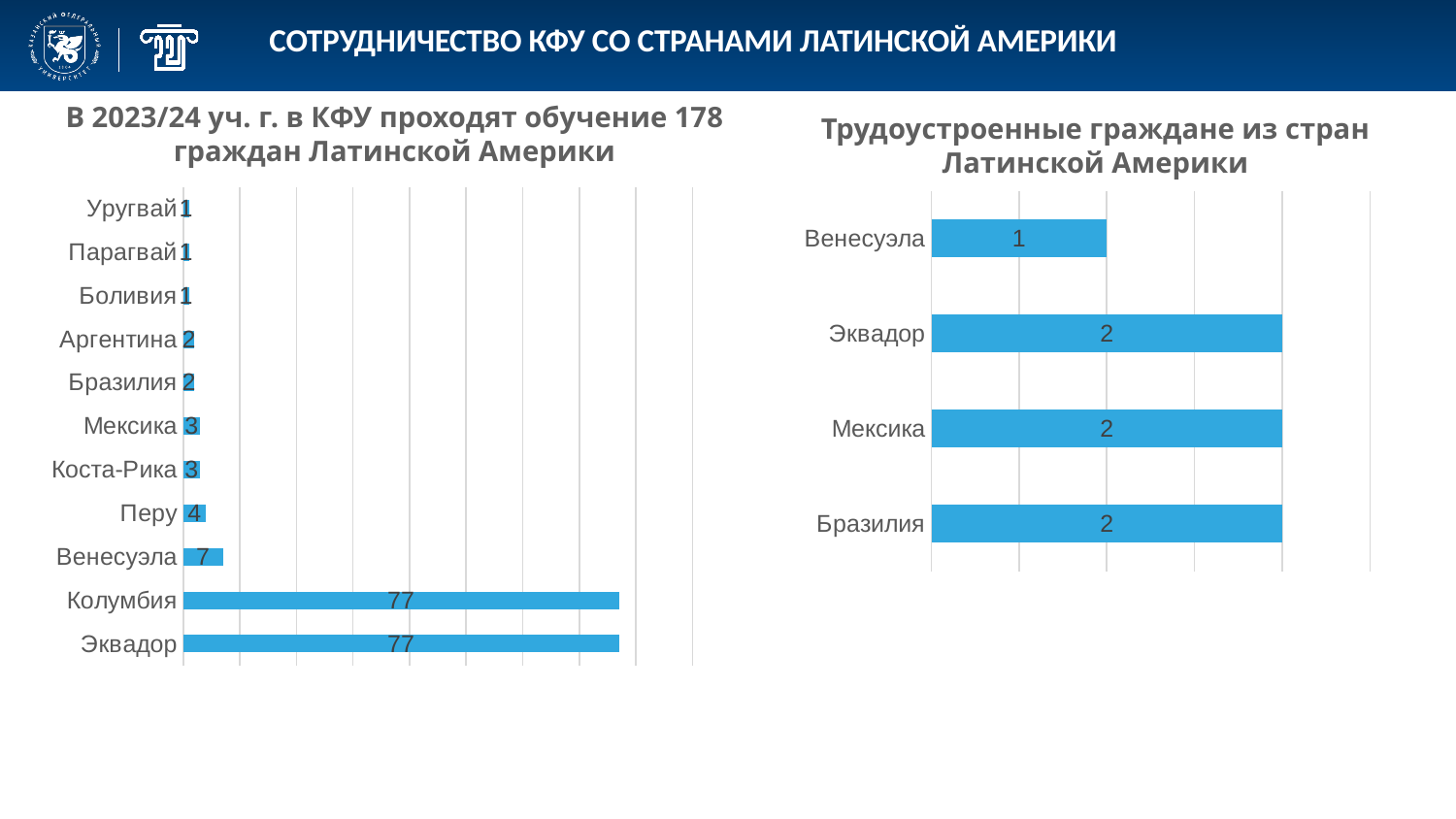
On the left chart (students from Latin America in 2023/24), how many students are from Перу? 4 On the left chart (students from Latin America in 2023/24), which is larger, the value for Перу or the value for Мексика? Перу What type of chart is the left chart (students from Latin America in 2023/24)? Bar chart On the left chart (students from Latin America in 2023/24), how many countries are shown? 11 On the left chart (students from Latin America in 2023/24), how many students are from Колумбия? 77 On the right chart (Трудоустроенные граждане из стран Латинской Америки), what is the value for Эквадор? 2 On the left chart (students from Latin America in 2023/24), which country has the lowest value among Перу, Мексика and Бразилия? Бразилия On the left chart (students from Latin America in 2023/24), how many students are from Венесуэла? 7 On the left chart (students from Latin America in 2023/24), what is the difference between the values for Эквадор and Венесуэла? 70 On the right chart (Трудоустроенные граждане из стран Латинской Америки), which country has the lowest value? Венесуэла On the right chart (Трудоустроенные граждане из стран Латинской Америки), what is the value for Венесуэла? 1 On the right chart (Трудоустроенные граждане из стран Латинской Америки), how many countries are shown? 4